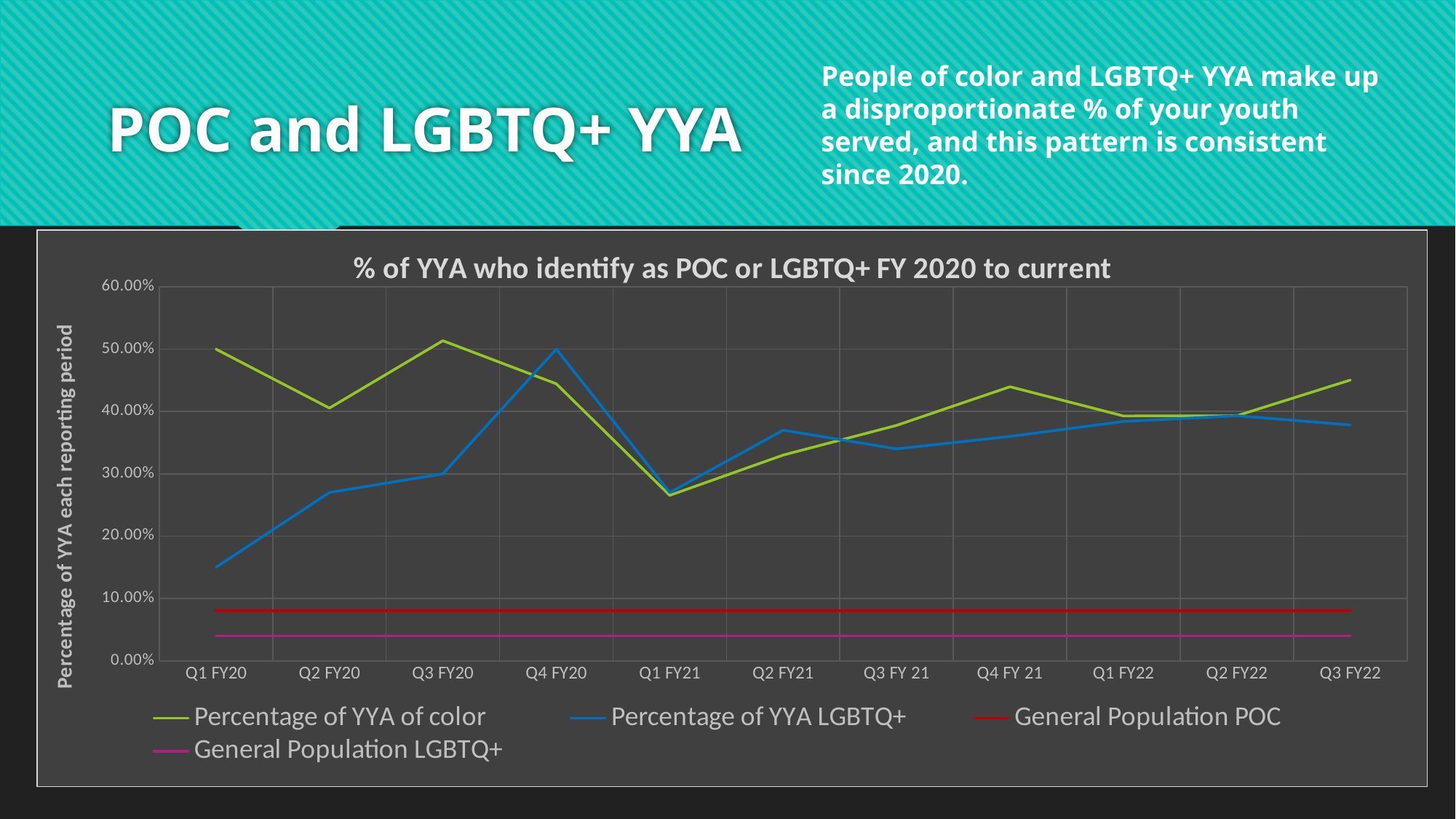
In which reporting period is the Percentage of YYA of color lowest? Q1 FY21 Is the Percentage of YYA LGBTQ+ in Q1 FY20 greater or less than 20.00%? less What is the title of the chart? % of YYA who identify as POC or LGBTQ+ FY 2020 to current Is the Percentage of YYA of color in Q3 FY22 greater or less than 40.00%? greater Is the General Population POC line greater or less than 10.00%? less In Q4 FY20, which is larger: the Percentage of YYA of color or the Percentage of YYA LGBTQ+? Percentage of YYA LGBTQ+ What kind of chart is shown on the slide? line chart How many reporting periods are shown on the x axis? 11 How many series does the legend list? 4 In which reporting period is the Percentage of YYA LGBTQ+ lowest? Q1 FY20 Does the Percentage of YYA LGBTQ+ rise or fall from Q1 FY20 to Q4 FY20? rise In which reporting period is the Percentage of YYA LGBTQ+ highest? Q4 FY20